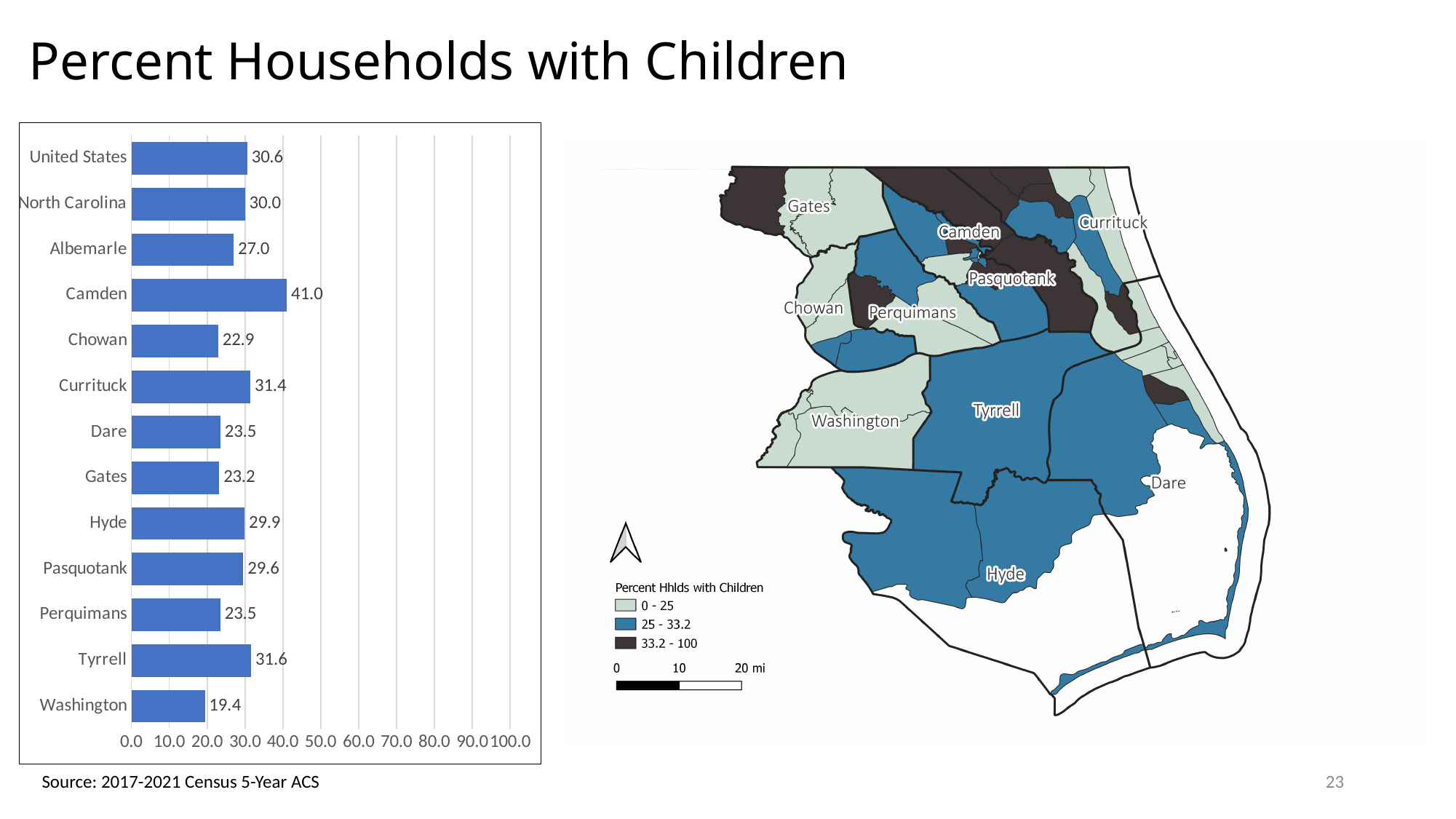
What kind of chart is shown on the left of the slide? bar chart In the bar chart, what is the value for Washington? 19.4 How many categories are shown in the bar chart? 13 In the bar chart, is the value for Camden greater or less than 40.0? greater In the bar chart, what is the difference between the values for Camden and Washington? 21.6 In the bar chart, which category has the lowest value? Washington In the bar chart, which is larger, the value for Camden or the value for Chowan? Camden In the bar chart, what is the value for Camden? 41.0 In the bar chart, what is the value for Pasquotank? 29.6 In the bar chart, what is the value for North Carolina? 30.0 How many classes does the map legend list for Percent Hhlds with Children? 3 In the bar chart, which category has the highest value? Camden